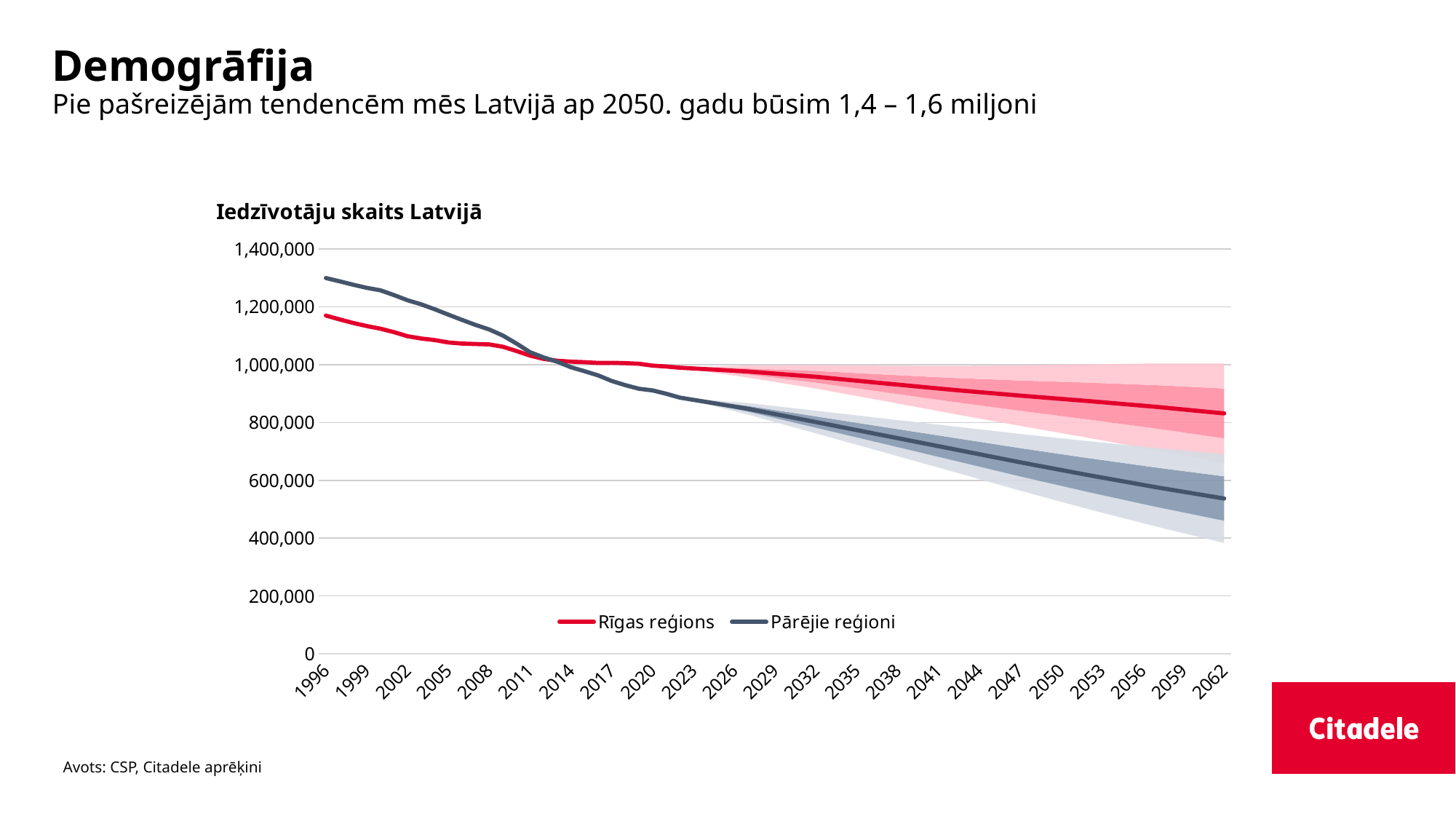
Is the value for Rīgas reģions in 1996 greater or less than 1,200,000? less Is the value for Pārējie reģioni in 2062 greater or less than 600,000? less In 1996, which series has the higher value, Rīgas reģions or Pārējie reģioni? Pārējie reģioni What kind of chart is shown on the slide? line chart What is the title of the chart? Iedzīvotāju skaits Latvijā In 2050, which series has the higher value, Rīgas reģions or Pārējie reģioni? Rīgas reģions Does the value for Pārējie reģioni rise or fall from 1996 to 2062? fall How many series does the legend list? 2 Which series is drawn in red? Rīgas reģions Is the value for Pārējie reģioni in 1996 greater or less than 1,200,000? greater Does the value for Rīgas reģions rise or fall from 1996 to 2062? fall